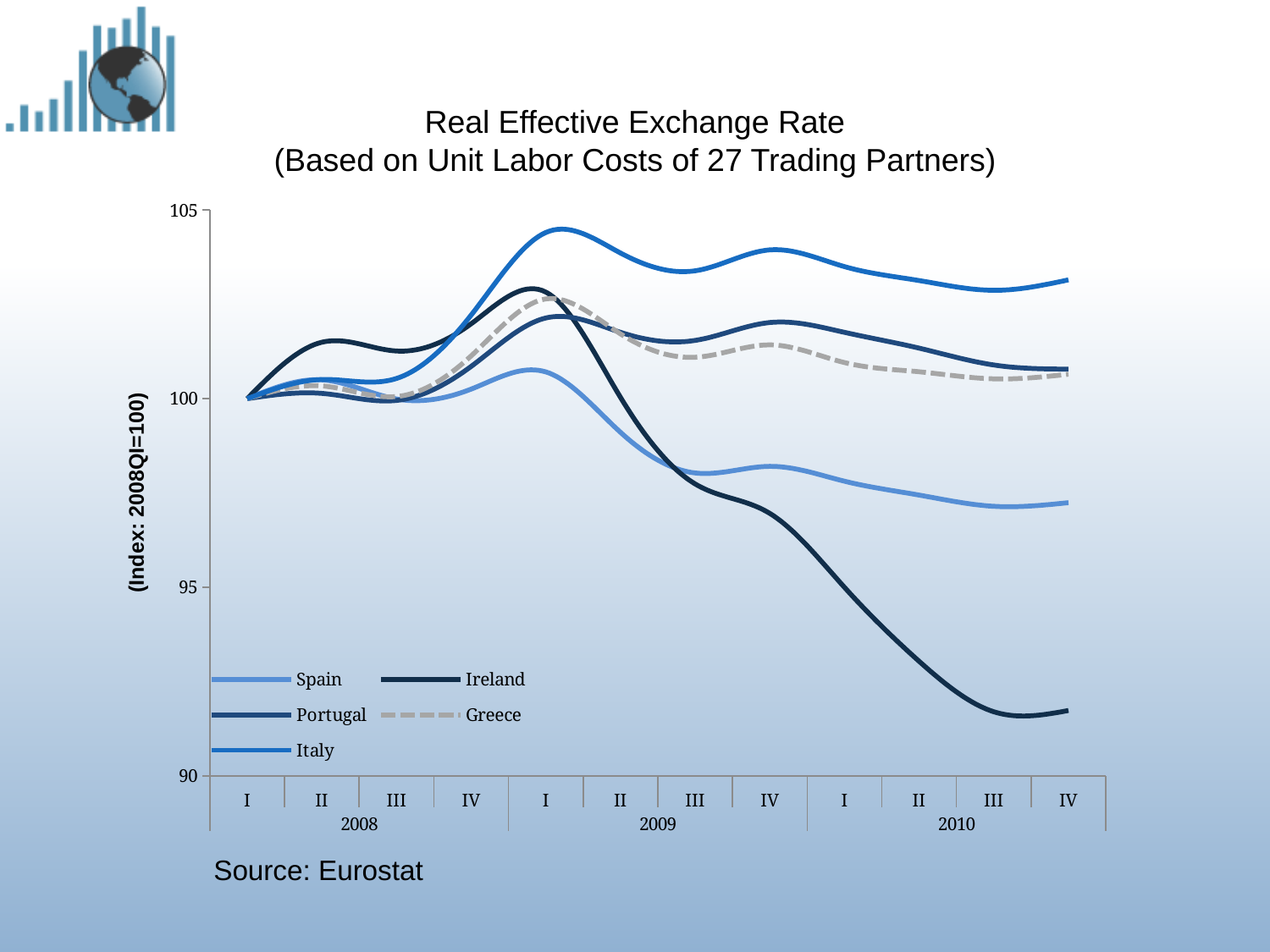
How many series does the legend list? 5 Which series has the lowest value in quarter IV of 2010? Ireland What kind of chart is shown on the slide? line chart How many quarterly points are shown along the x axis? 12 Which series has the highest value in quarter IV of 2010? Italy Is the value for Ireland in quarter IV of 2010 greater or less than 95? less What is the value of the Spain series in quarter I of 2008? 100 Which series is drawn with a dashed line? Greece Is the value for Italy in quarter I of 2009 greater or less than 100? greater Is the value for Spain in quarter IV of 2010 greater or less than 100? less Does the Ireland series rise or fall from quarter I of 2009 to quarter IV of 2010? fall In quarter IV of 2010, which is larger, the value for Spain or the value for Ireland? Spain